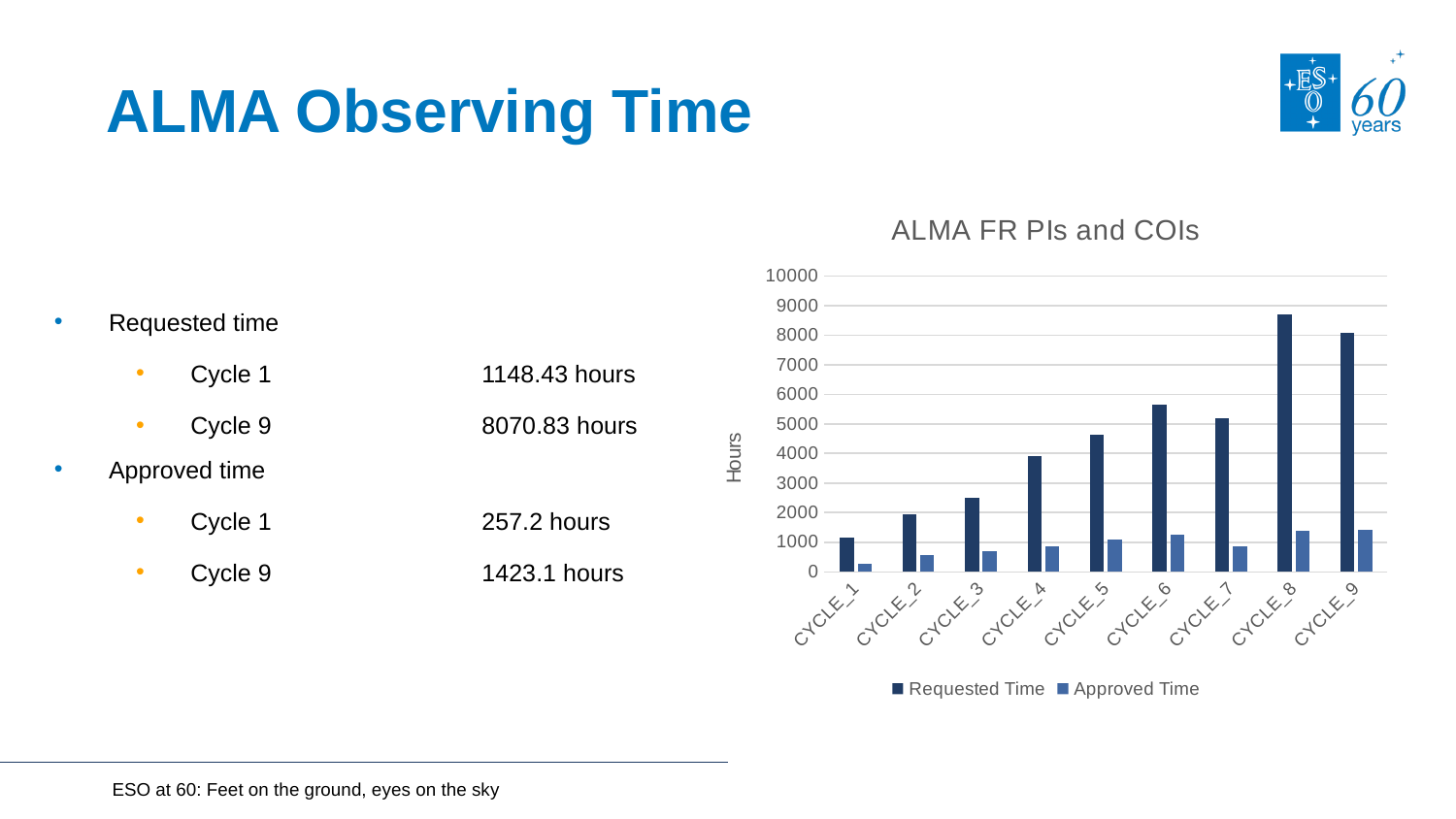
Is the Requested Time for CYCLE_6 greater or less than 5000? greater How many cycles are shown on the x axis of the chart? 9 What is the title of the chart? ALMA FR PIs and COIs Is the Requested Time for CYCLE_8 greater or less than 8000? greater What is the difference between the Approved Time for Cycle 9 and Cycle 1, using the values stated on the slide? 1165.9 hours Which cycle has the lowest Approved Time? CYCLE_1 Which has the larger Requested Time, CYCLE_6 or CYCLE_7? CYCLE_6 Which cycle has the highest Requested Time? CYCLE_8 Is the Approved Time for CYCLE_3 greater or less than 1000? less What type of chart is shown on the slide? Bar chart What is the Requested Time for Cycle 9, as stated on the slide? 8070.83 hours How many series does the chart legend list? 2